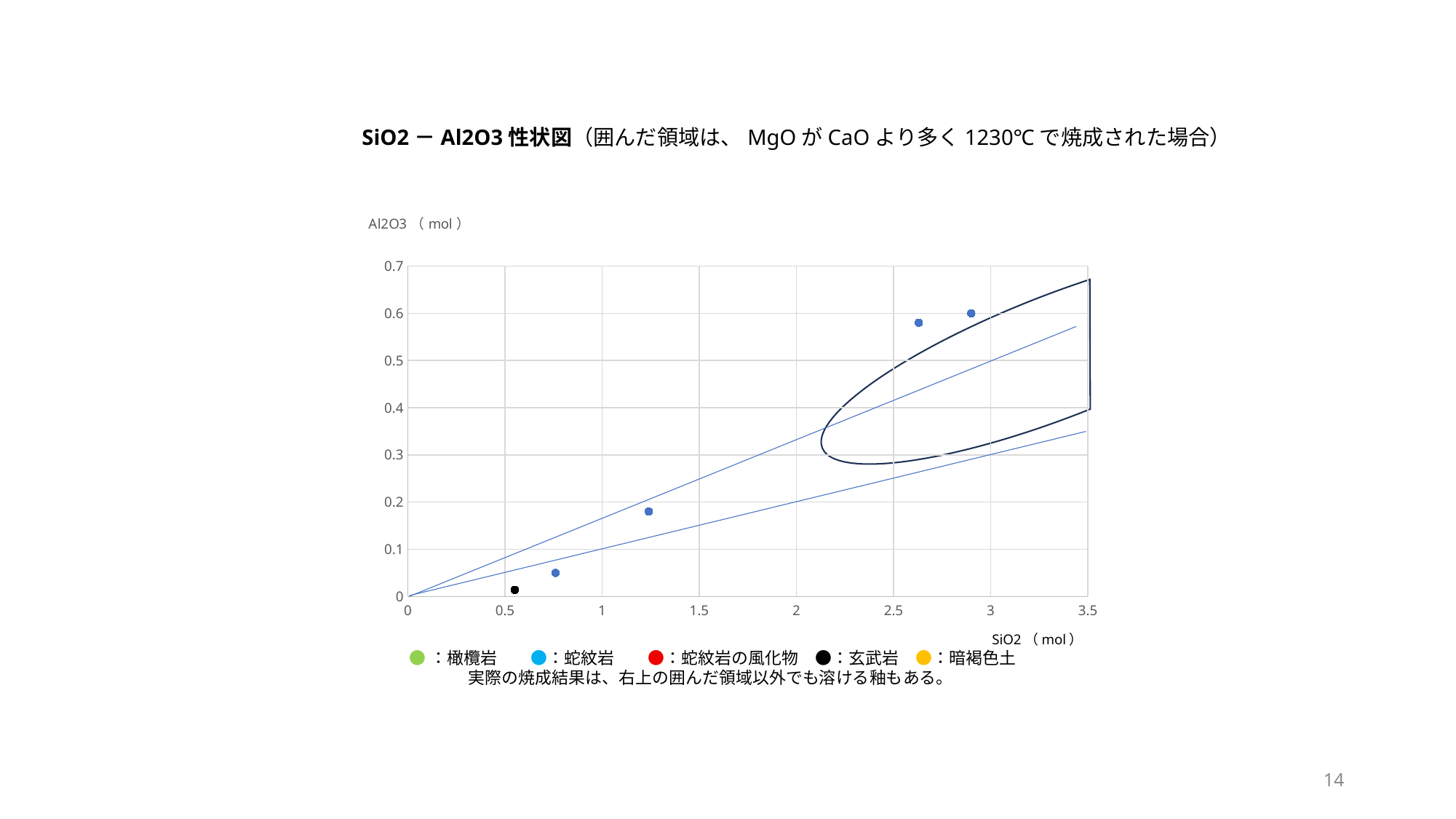
What kind of chart is shown on the slide? scatter chart How many blue data points are plotted on the chart? 4 How many data points are plotted on the chart? 5 Is the Al2O3 value of the black data point greater or less than 0.1? less What is the highest tick value shown on the x axis (SiO2)? 3.5 Is the Al2O3 value of the blue point located near SiO2 = 2.9 greater or less than 0.5? greater How many plotted points have a SiO2 value greater than 2.5? 2 What colour is the legend marker for 玄武岩? black Do the plotted Al2O3 values rise or fall as SiO2 increases along the x axis? rise Is the Al2O3 value of the blue point located near SiO2 = 1.25 greater or less than 0.2? less How many entries does the legend below the chart list? 5